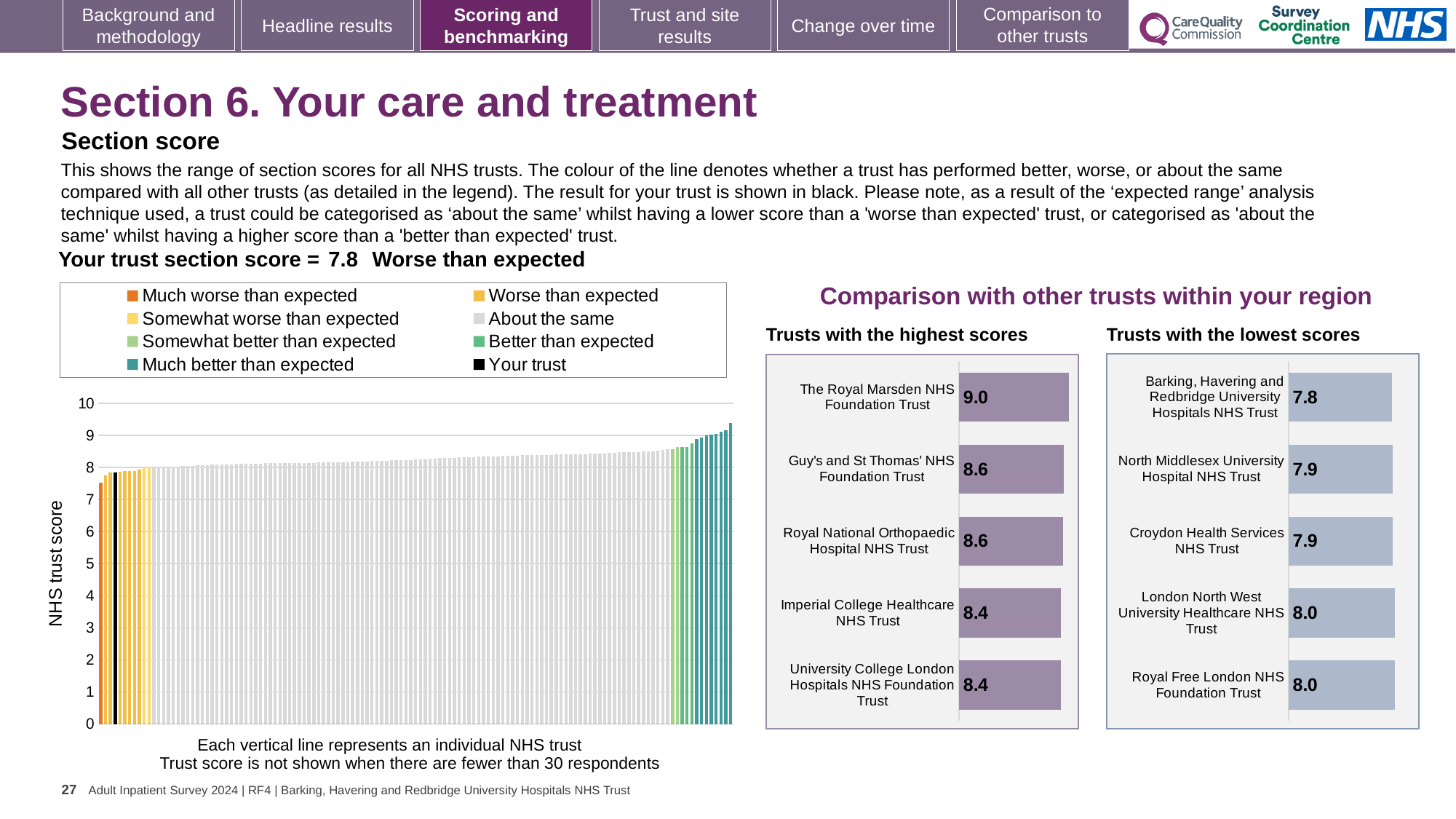
In the 'Trusts with the highest scores' chart, which trust has the highest score? The Royal Marsden NHS Foundation Trust In the 'Trusts with the lowest scores' chart, which trust has the lowest score? Barking, Havering and Redbridge University Hospitals NHS Trust In the 'Trusts with the highest scores' chart, what is the difference between the scores of The Royal Marsden NHS Foundation Trust and Guy's and St Thomas' NHS Foundation Trust? 0.4 In the 'Trusts with the lowest scores' chart, what is the score for Royal Free London NHS Foundation Trust? 8.0 In the 'Trusts with the highest scores' chart, what is the score for Imperial College Healthcare NHS Trust? 8.4 How many entries does the legend of the main NHS trust score chart list? 8 In the main NHS trust score chart on the left, do the values rise or fall from left to right along the x axis? Rise What kind of chart is the main chart showing NHS trust scores on the left of the slide? Bar chart In the 'Trusts with the lowest scores' chart, what is the score for Croydon Health Services NHS Trust? 7.9 In the 'Trusts with the highest scores' chart, what is the score for The Royal Marsden NHS Foundation Trust? 9.0 In the 'Trusts with the lowest scores' chart, which has the larger score: North Middlesex University Hospital NHS Trust or London North West University Healthcare NHS Trust? London North West University Healthcare NHS Trust How many trusts are shown in the 'Trusts with the highest scores' chart? 5